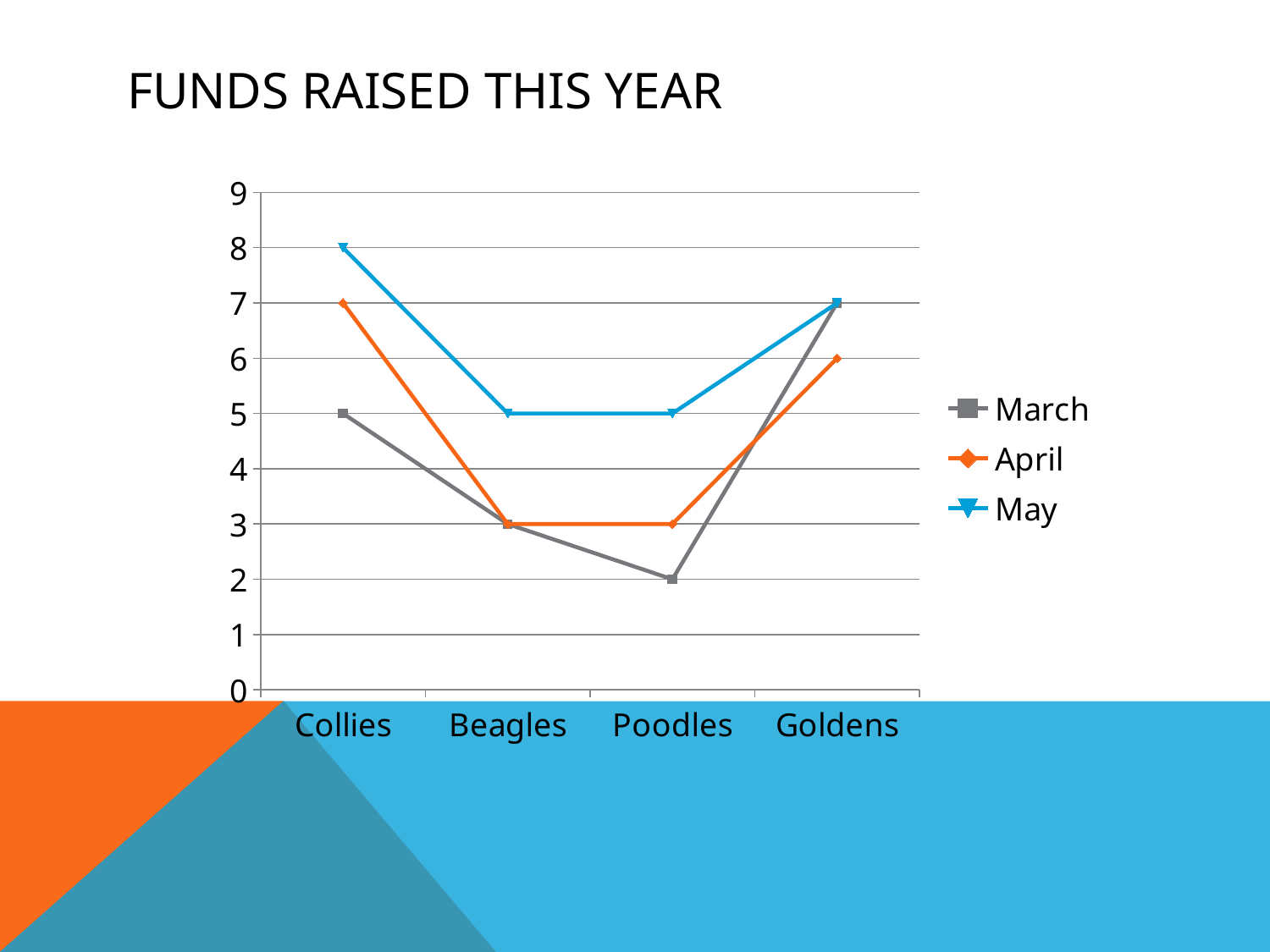
What kind of chart is shown on the slide? Line chart How many categories are shown on the x axis? 4 What is the value for May for Collies? 8 What is the difference between the May and March values for Collies? 3 Which category has the highest value for March? Goldens Which category has the lowest value for May? Beagles and Poodles What is the title of the chart? FUNDS RAISED THIS YEAR Which is larger for Goldens, the March value or the April value? March How many series does the legend list? 3 What is the value for March for Poodles? 2 Is the value for April for Collies greater or less than 6? greater What is the value for April for Goldens? 6